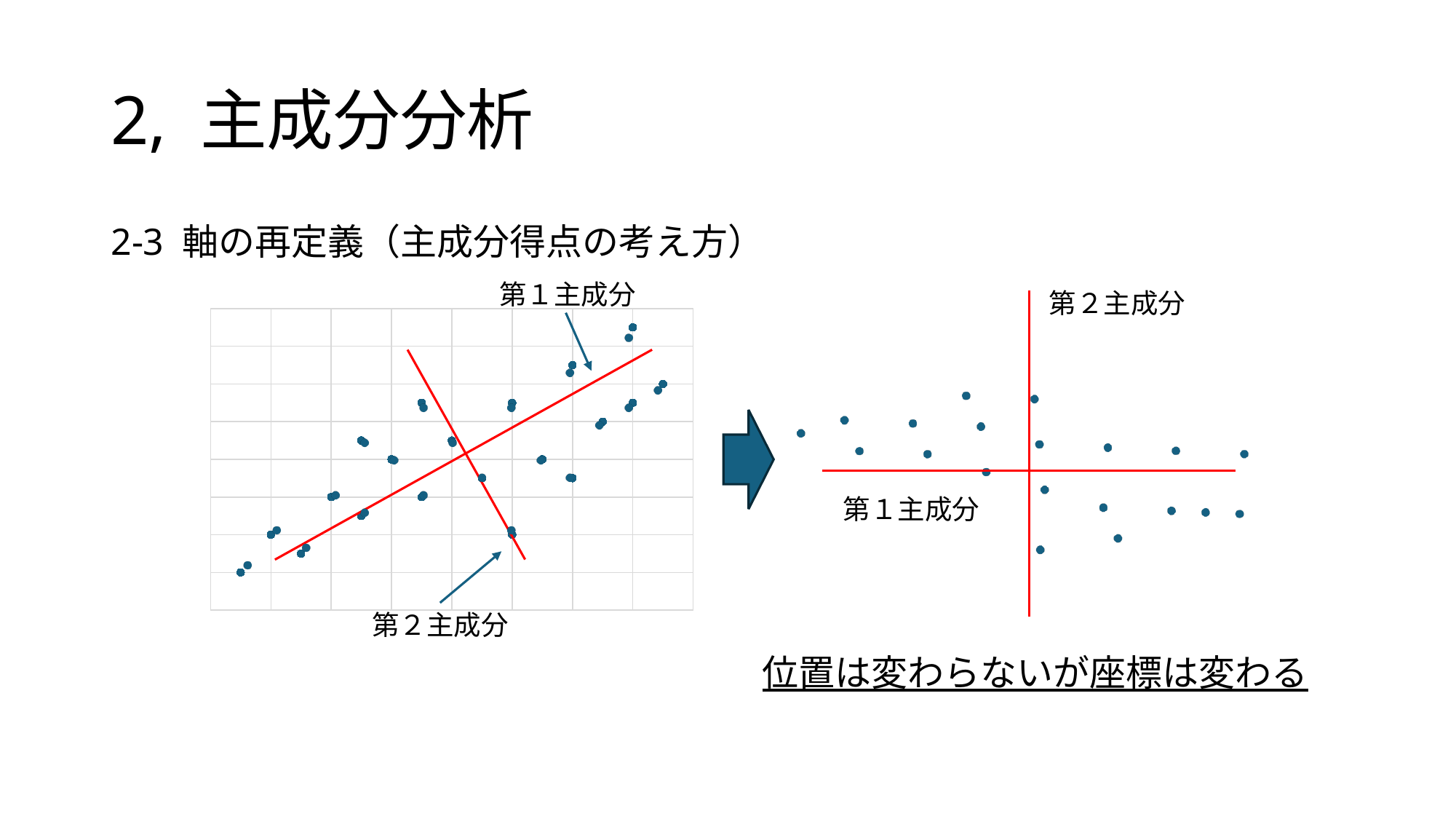
What kind of chart is the left chart on the slide? scatter chart What kind of chart is the right chart on the slide? scatter chart In the right chart, what is the label of the vertical red axis? 第２主成分 In the left chart, do the points generally rise or fall from left to right? rise In the left chart, what is the label of the red line running from lower left to upper right? 第１主成分